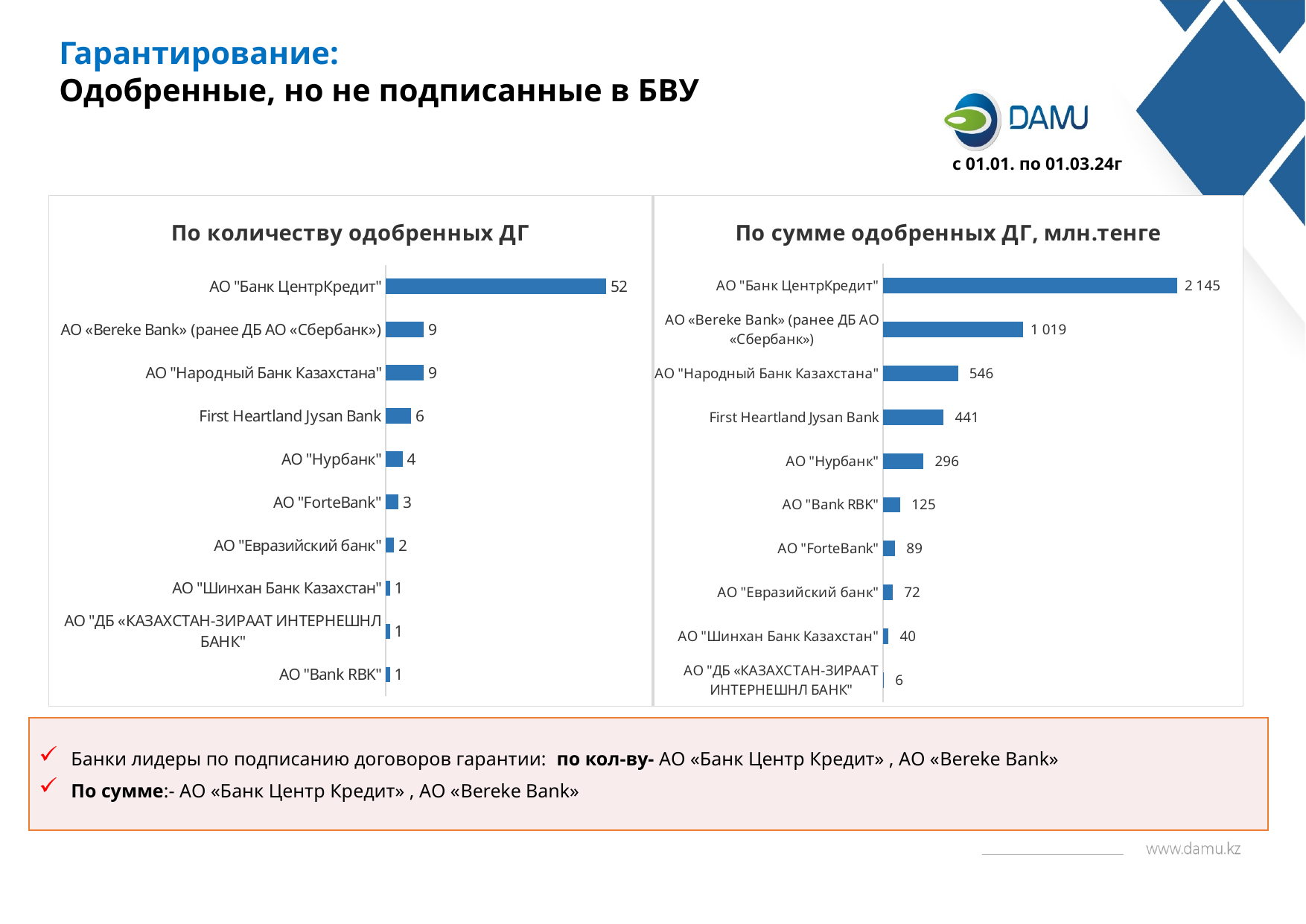
How many banks are shown in the chart "По сумме одобренных ДГ, млн.тенге"? 10 In the chart "По количеству одобренных ДГ", which bank has the highest value? АО "Банк ЦентрКредит" In the chart "По сумме одобренных ДГ, млн.тенге", what is the value for First Heartland Jysan Bank? 441 In the chart "По количеству одобренных ДГ", which is larger: First Heartland Jysan Bank or АО "ForteBank"? First Heartland Jysan Bank In the chart "По количеству одобренных ДГ", what is the difference between АО "Банк ЦентрКредит" and АО "Народный Банк Казахстана"? 43 What type of chart is "По количеству одобренных ДГ"? Bar chart In the chart "По сумме одобренных ДГ, млн.тенге", what is the value for АО «Bereke Bank» (ранее ДБ АО «Сбербанк»)? 1 019 In the chart "По сумме одобренных ДГ, млн.тенге", what is the difference between АО "Банк ЦентрКредит" and АО «Bereke Bank»? 1 126 In the chart "По сумме одобренных ДГ, млн.тенге", which is larger: АО "Нурбанк" or АО "Bank RBK"? АО "Нурбанк" In the chart "По количеству одобренных ДГ", what is the value for АО "Нурбанк"? 4 In the chart "По количеству одобренных ДГ", what is the value for АО "Банк ЦентрКредит"? 52 In the chart "По сумме одобренных ДГ, млн.тенге", which bank has the lowest value? АО "ДБ «КАЗАХСТАН-ЗИРААТ ИНТЕРНЕШНЛ БАНК"